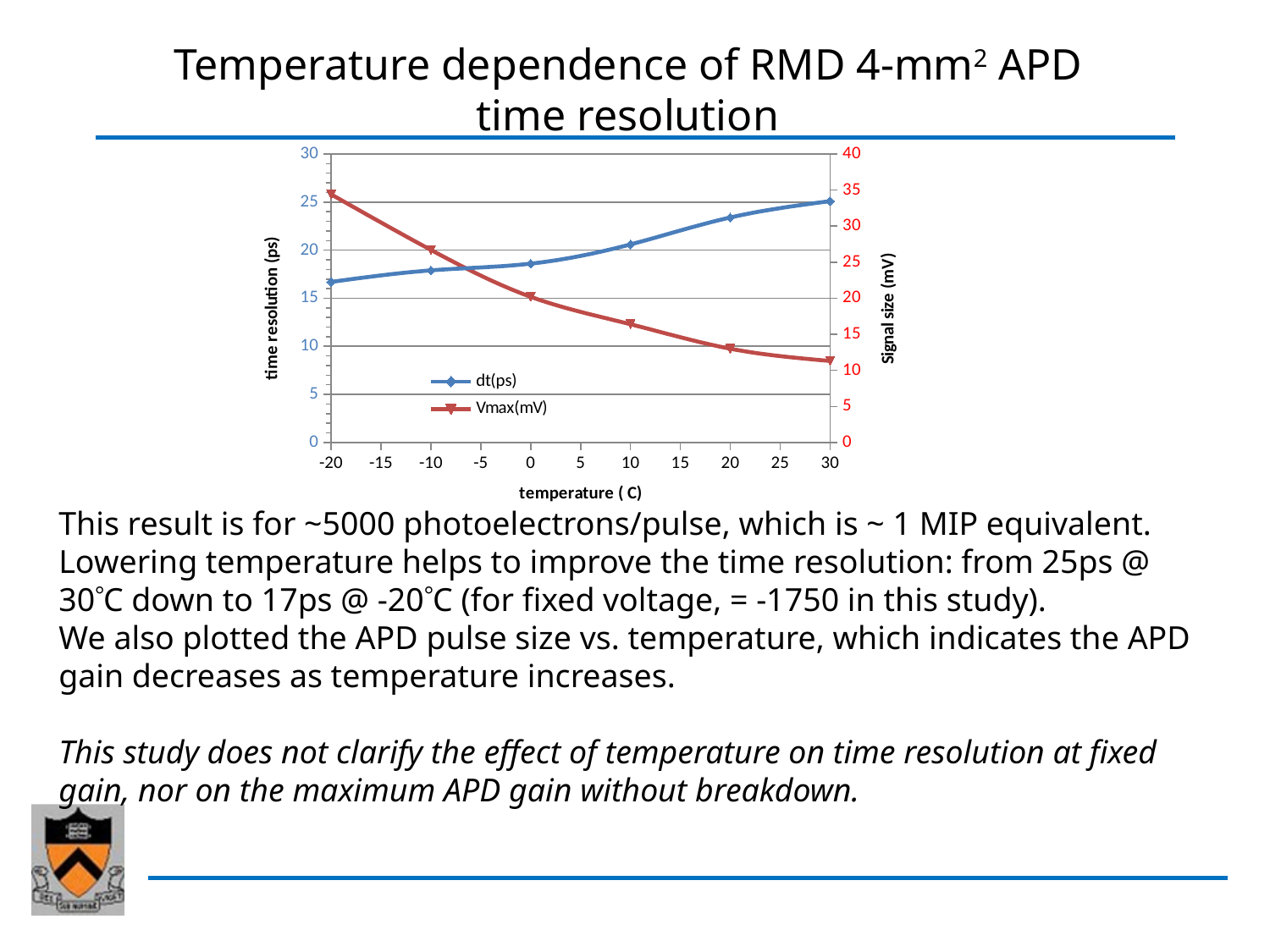
At which temperature is the dt(ps) value highest? 30 What kind of chart is shown on the slide? line chart Does the dt(ps) series rise or fall as temperature increases along the x axis? rise Does the Vmax(mV) series rise or fall as temperature increases along the x axis? fall At which temperature is the dt(ps) value lowest? -20 How many temperature points are plotted for each series? 6 At which temperature is the Vmax(mV) value highest? -20 Is the Vmax(mV) value at 30 °C greater or less than 15 on the right axis? less Is the dt(ps) value at 30 °C greater or less than 20 on the left axis? greater Is the Vmax(mV) value at -20 °C greater or less than 30 on the right axis? greater How many series does the chart legend list? 2 What is the title of the chart's x axis? temperature ( C)